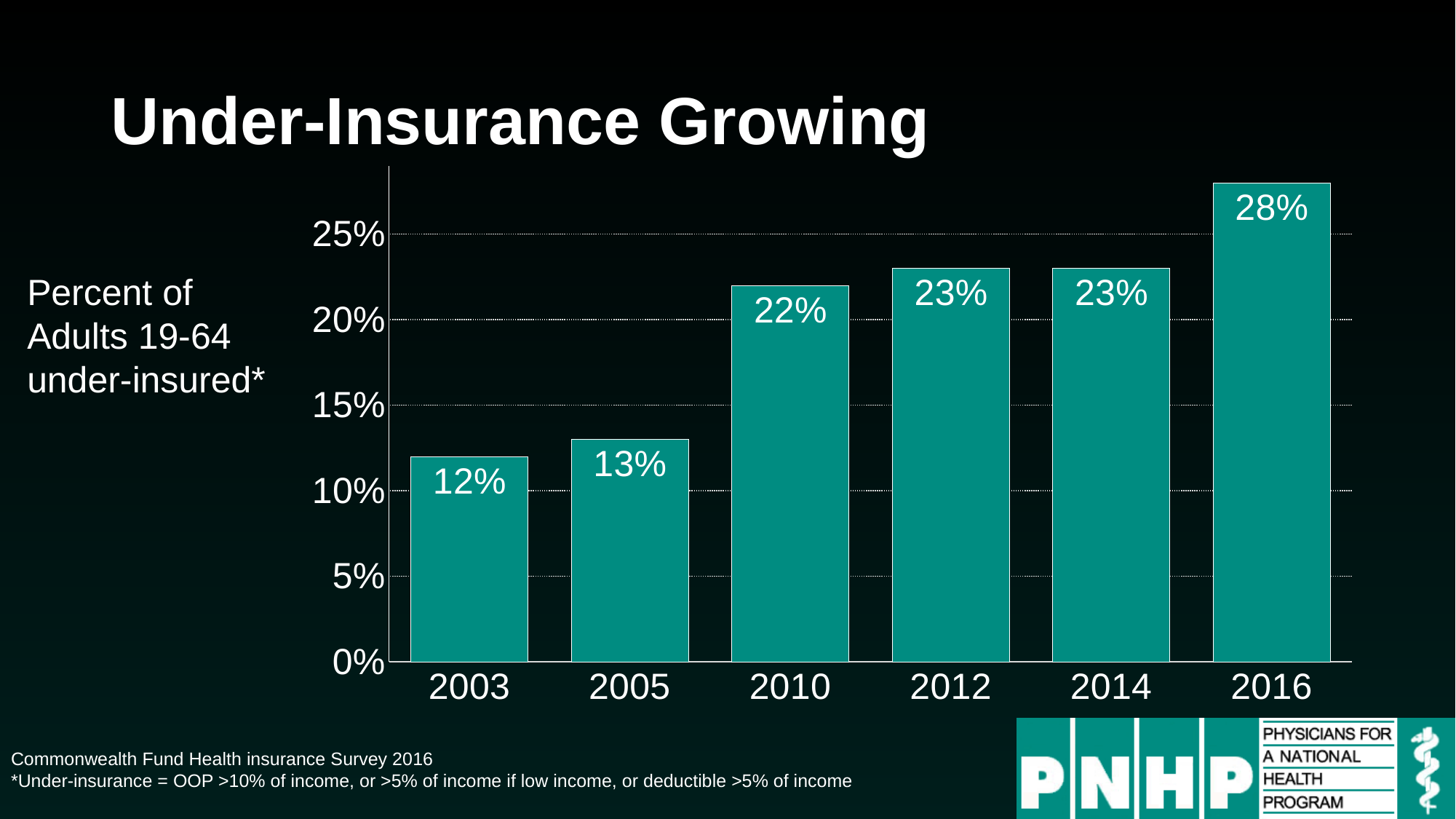
What is the value shown for 2016? 28% Which year has the highest percentage of under-insured adults? 2016 What percent of adults 19-64 were under-insured in 2003? 12% Do the values generally rise or fall from 2003 to 2016? Rise What is the difference between the 2016 value and the 2003 value? 16% Which is larger, the value for 2005 or the value for 2012? 2012 What is the difference between the 2010 value and the 2005 value? 9% What kind of chart is shown on the slide? Bar chart Which year has the lowest percentage of under-insured adults? 2003 How many years are shown on the x axis? 6 What is the value shown for 2010? 22% Is the value for 2014 greater or less than 20%? greater